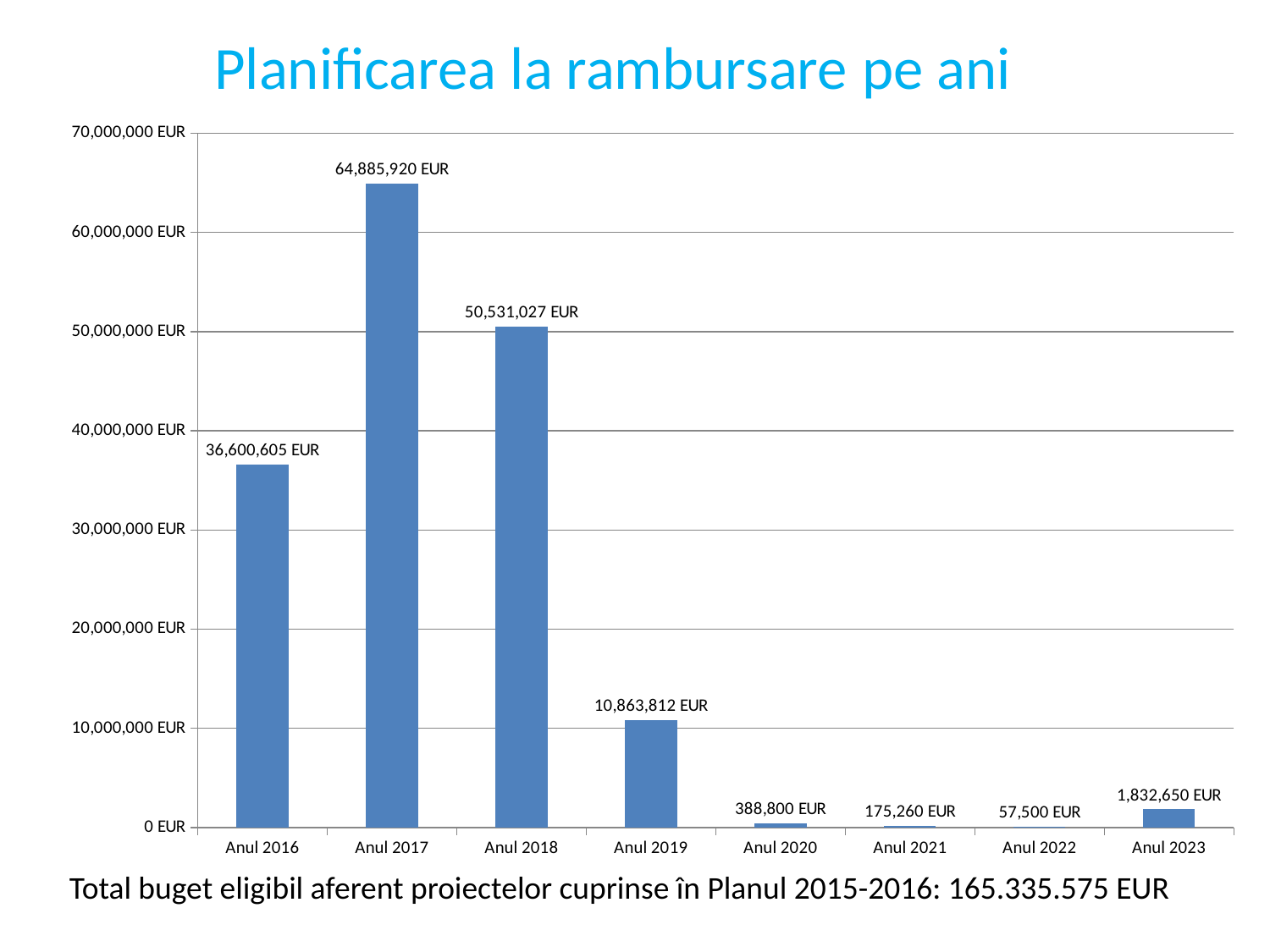
How many years are shown on the x axis? 8 What is the value for Anul 2019? 10,863,812 EUR Is the value for Anul 2016 greater or less than 40,000,000 EUR? less What is the difference between the values for Anul 2017 and Anul 2018? 14,354,893 EUR Which year has the highest value? Anul 2017 What is the value for Anul 2017? 64,885,920 EUR What kind of chart is shown on the slide? bar chart What is the difference between the values for Anul 2023 and Anul 2022? 1,775,150 EUR Which is larger, the value for Anul 2016 or the value for Anul 2018? Anul 2018 Which year has the lowest value? Anul 2022 What is the value for Anul 2022? 57,500 EUR What is the title of the chart? Planificarea la rambursare pe ani